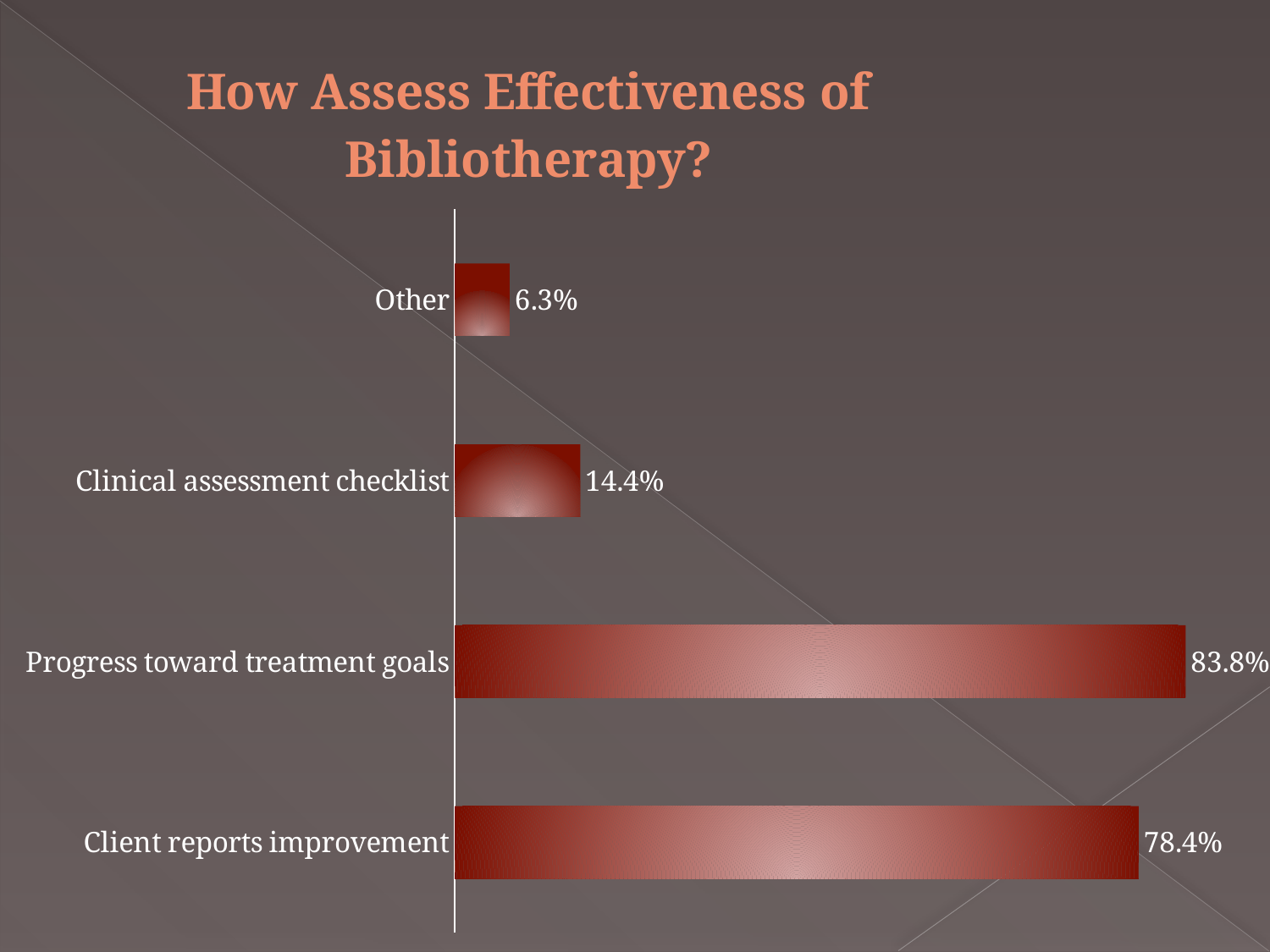
What kind of chart is shown on the slide? Bar chart What is the difference between Clinical assessment checklist and Other? 8.1% What is the value for Clinical assessment checklist? 14.4% What is the title of the slide? How Assess Effectiveness of Bibliotherapy? How many categories are shown in the chart? 4 What is the value for Progress toward treatment goals? 83.8% Which category has the highest value? Progress toward treatment goals What is the value for Other? 6.3% Which is larger, Clinical assessment checklist or Other? Clinical assessment checklist What is the value for Client reports improvement? 78.4% Which category has the lowest value? Other What is the difference between Progress toward treatment goals and Client reports improvement? 5.4%